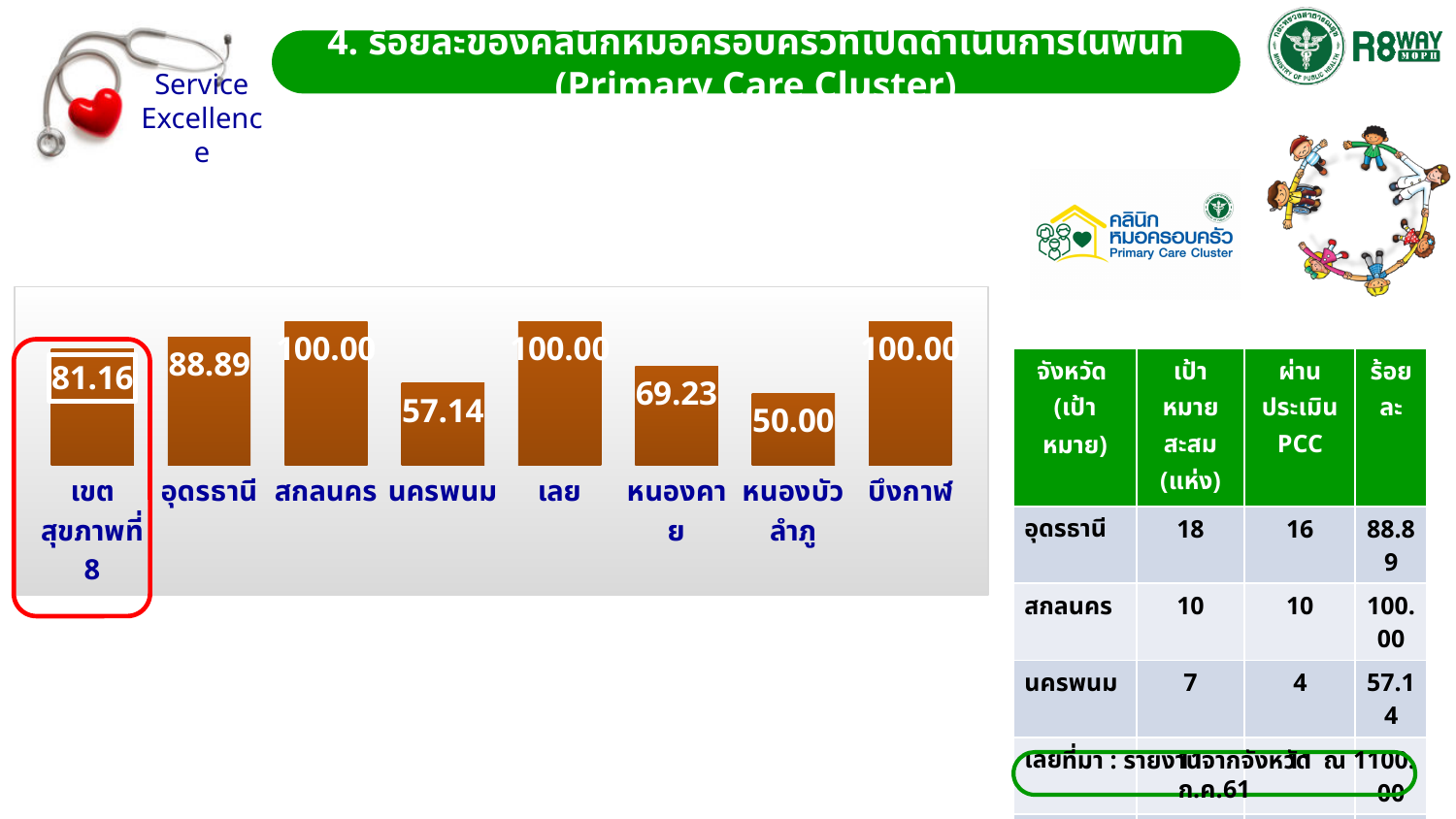
What is the value for หนองคาย in the bar chart? 69.23 Which category has the lowest value in the bar chart? หนองบัวลำภู Which category in the bar chart is highlighted with a red outline? เขตสุขภาพที่ 8 How many categories are shown in the bar chart? 8 What is the difference between the values for อุดรธานี and นครพนม in the bar chart? 31.75 What kind of chart is shown on the slide? bar chart What is the value for นครพนม in the bar chart? 57.14 How many categories in the bar chart have a value of 100.00? 3 What is the value for อุดรธานี in the bar chart? 88.89 What is the value for เขตสุขภาพที่ 8 in the bar chart? 81.16 What is the difference between the values for เขตสุขภาพที่ 8 and หนองบัวลำภู in the bar chart? 31.16 Which is larger in the bar chart, the value for หนองคาย or the value for นครพนม? หนองคาย